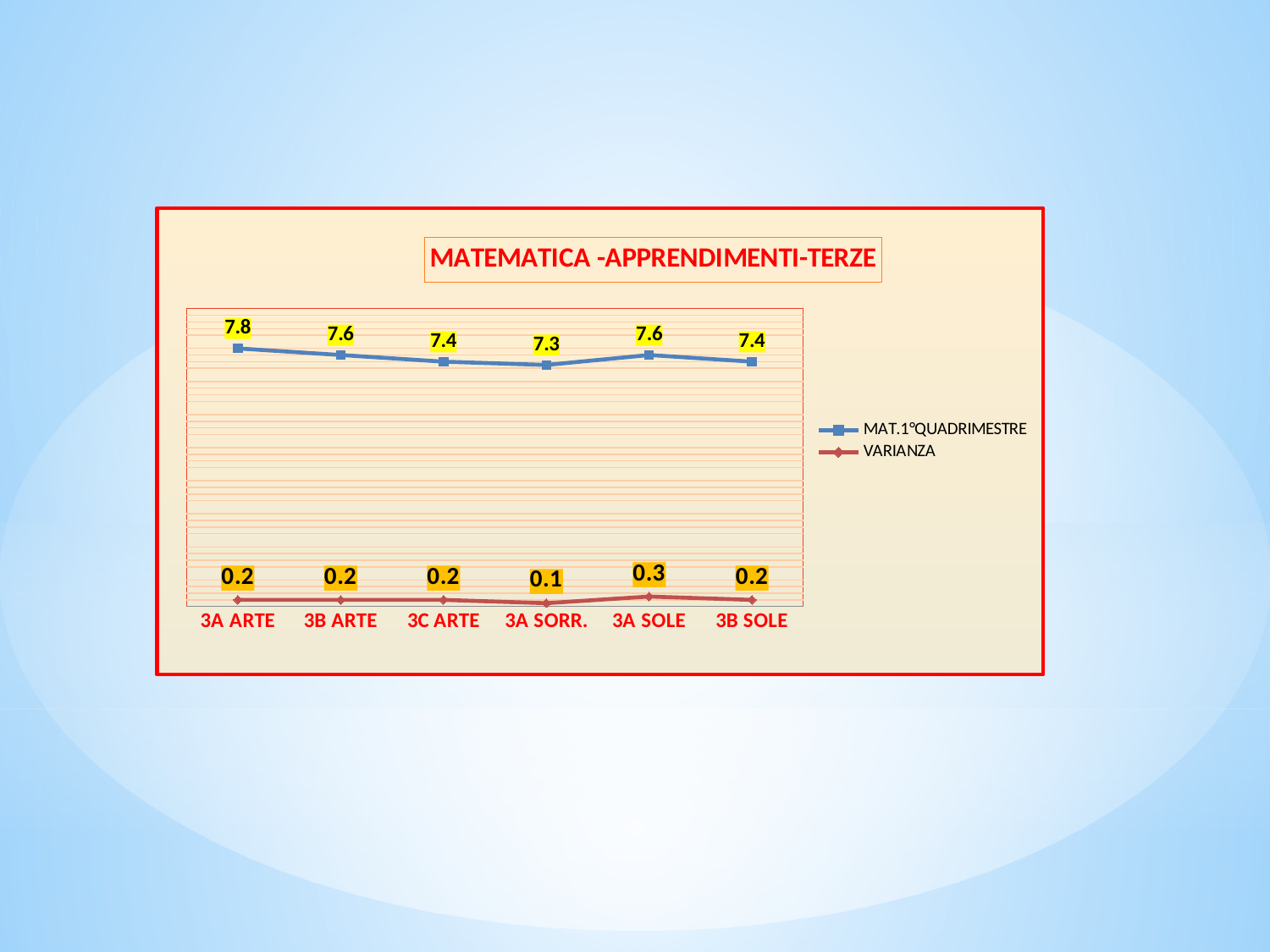
Which is larger, the MAT.1°QUADRIMESTRE value for 3B ARTE or for 3C ARTE? 3B ARTE Which category has the lowest MAT.1°QUADRIMESTRE value? 3A SORR. Which category has the lowest VARIANZA value? 3A SORR. What is the MAT.1°QUADRIMESTRE value for 3A SORR.? 7.3 What is the difference between the MAT.1°QUADRIMESTRE values for 3A ARTE and 3A SORR.? 0.5 How many series does the legend list? 2 What is the VARIANZA value for 3A SOLE? 0.3 Which category has the highest MAT.1°QUADRIMESTRE value? 3A ARTE How many categories are shown on the x axis? 6 What kind of chart is shown on the slide? Line chart What is the MAT.1°QUADRIMESTRE value for 3A ARTE? 7.8 What is the title of the chart? MATEMATICA -APPRENDIMENTI-TERZE